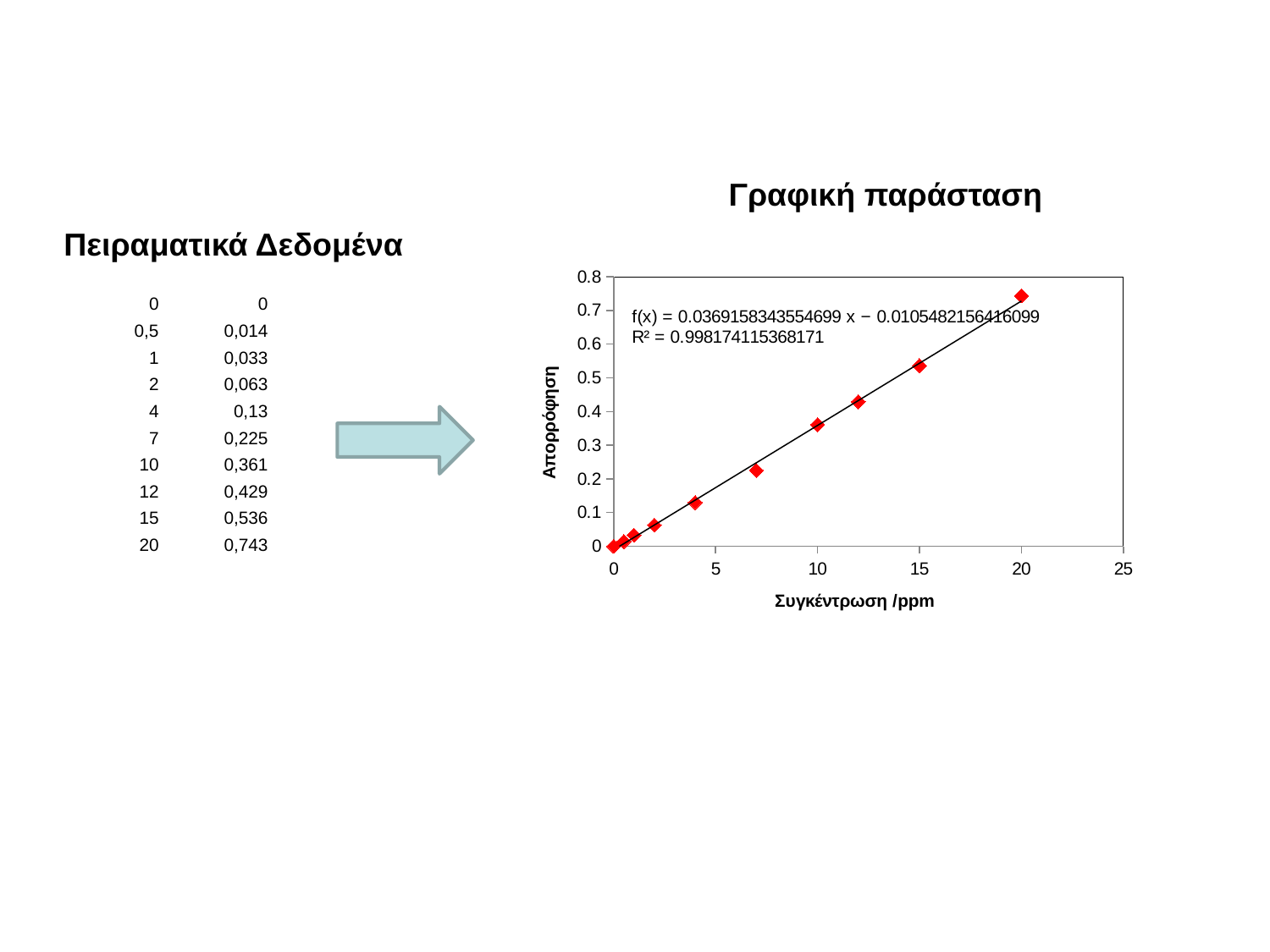
What is the title of the x axis of the chart? Συγκέντρωση /ppm According to the data table on the slide, what is the absorbance at 20 ppm? 0,743 Is the absorbance at 10 ppm greater or less than 0.3? greater What R² value is shown on the chart? 0.998174115368171 According to the data table on the slide, what is the absorbance at 15 ppm? 0,536 Is the absorbance at 4 ppm greater or less than 0.2? less How many data points are plotted on the chart? 10 At which concentration is the absorbance highest? 20 ppm What kind of chart is shown on the slide? scatter chart Do the absorbance values rise or fall as concentration increases along the x axis? rise Which has the larger absorbance, 12 ppm or 7 ppm? 12 ppm At which concentration is the absorbance lowest? 0 ppm